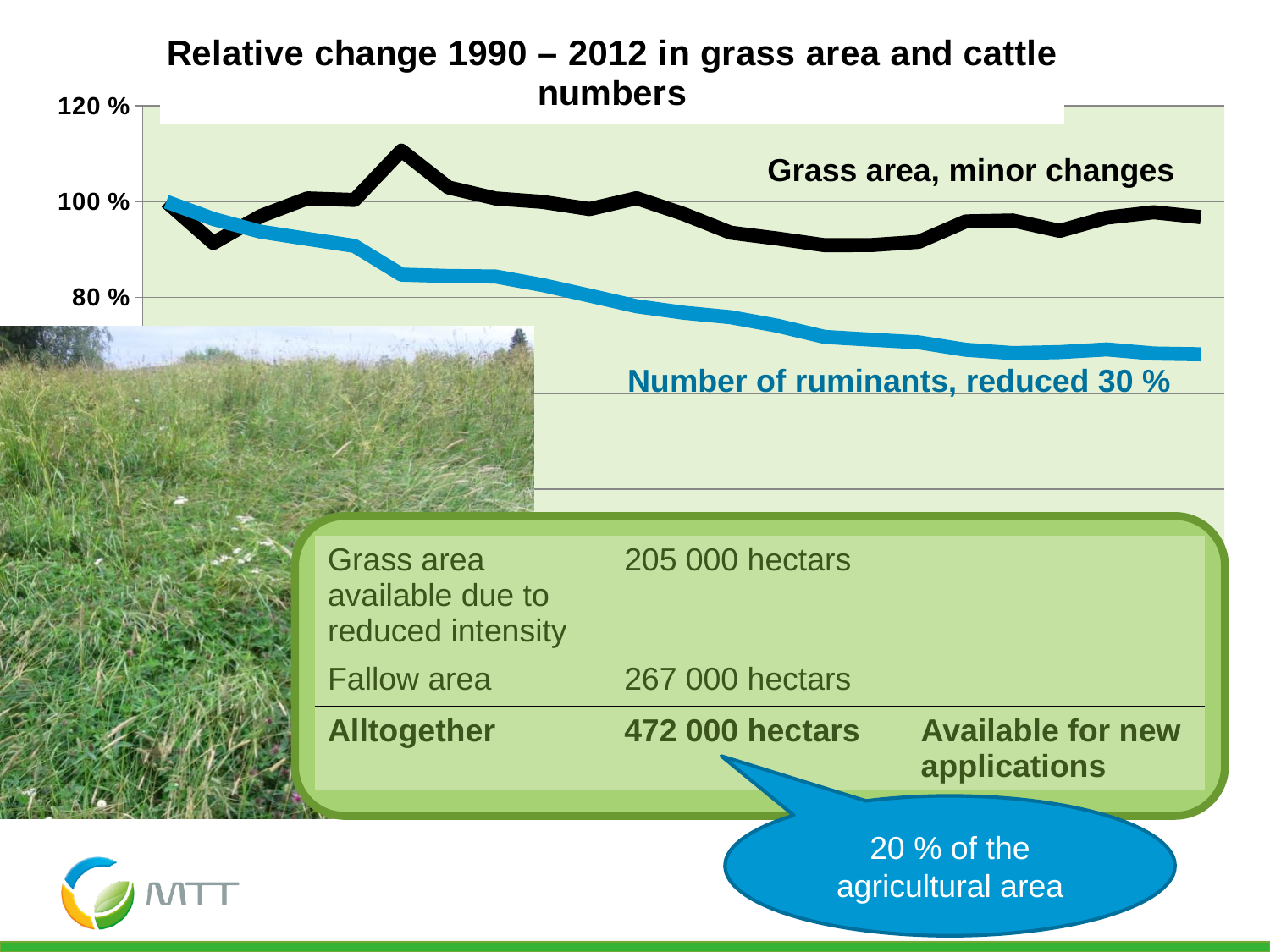
Is the final value of the number of ruminants line greater or less than 80 %? less Is the highest point of the grass area line greater or less than 120 %? less How many data series are plotted in the chart? 2 Is the highest point of the grass area line greater or less than 100 %? greater At what value do both lines start at the left of the chart? 100 % What kind of chart is shown on the slide? line chart According to the annotation on the chart, by how much was the number of ruminants reduced? 30 % At the right end of the chart, which line is higher: grass area or number of ruminants? grass area Which colour is the line for the number of ruminants? blue What is the title of the chart? Relative change 1990 – 2012 in grass area and cattle numbers Does the number of ruminants line rise or fall from left to right? fall